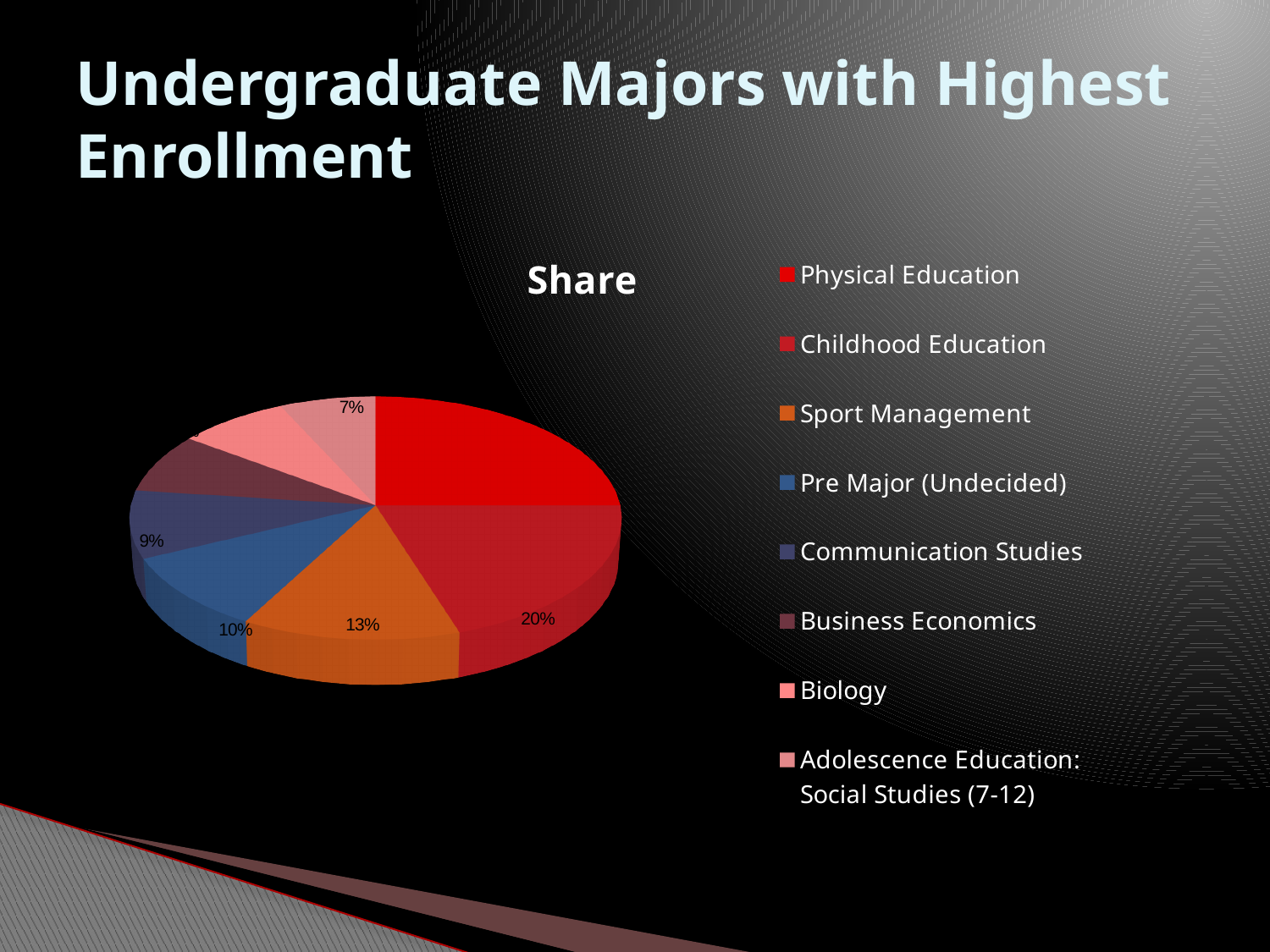
What is the difference between the Pre Major (Undecided) share and the Adolescence Education: Social Studies (7-12) share? 3 percentage points Which category has the largest slice of the pie? Physical Education How many percentage points larger is the Childhood Education share than the Sport Management share? 7 percentage points What share of the pie does Sport Management have? 13% Which has the larger share, Sport Management or Pre Major (Undecided)? Sport Management What share of the pie does Adolescence Education: Social Studies (7-12) have? 7% What is the title of the chart? Share What share of the pie does Pre Major (Undecided) have? 10% What share of the pie does Childhood Education have? 20% How many categories does the legend of the pie chart list? 8 What kind of chart is shown on the slide? pie chart What share of the pie does Communication Studies have? 9%